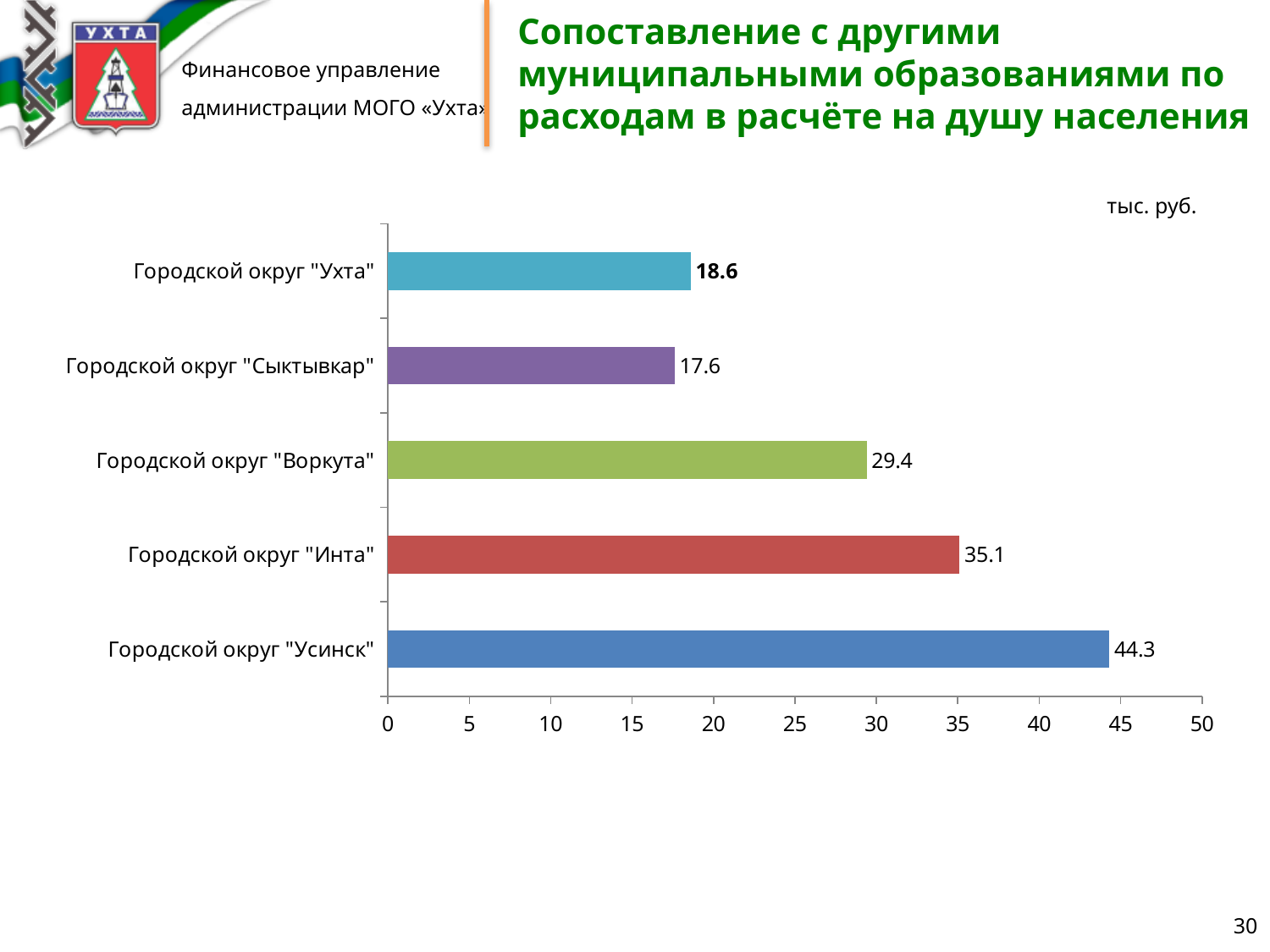
What is the difference between the values for Городской округ "Усинск" and Городской округ "Инта"? 9.2 What is the value for Городской округ "Усинск"? 44.3 Which municipality has the lowest value? Городской округ "Сыктывкар" What kind of chart is shown on the slide? bar chart How many municipalities are shown in the chart? 5 Which municipality has the highest value? Городской округ "Усинск" Which is larger, the value for Городской округ "Воркута" or Городской округ "Инта"? Городской округ "Инта" What is the value for Городской округ "Ухта"? 18.6 What unit is indicated above the chart? тыс. руб. What is the value for Городской округ "Воркута"? 29.4 Is the value for Городской округ "Инта" greater or less than 30? greater What is the difference between the values for Городской округ "Ухта" and Городской округ "Сыктывкар"? 1.0